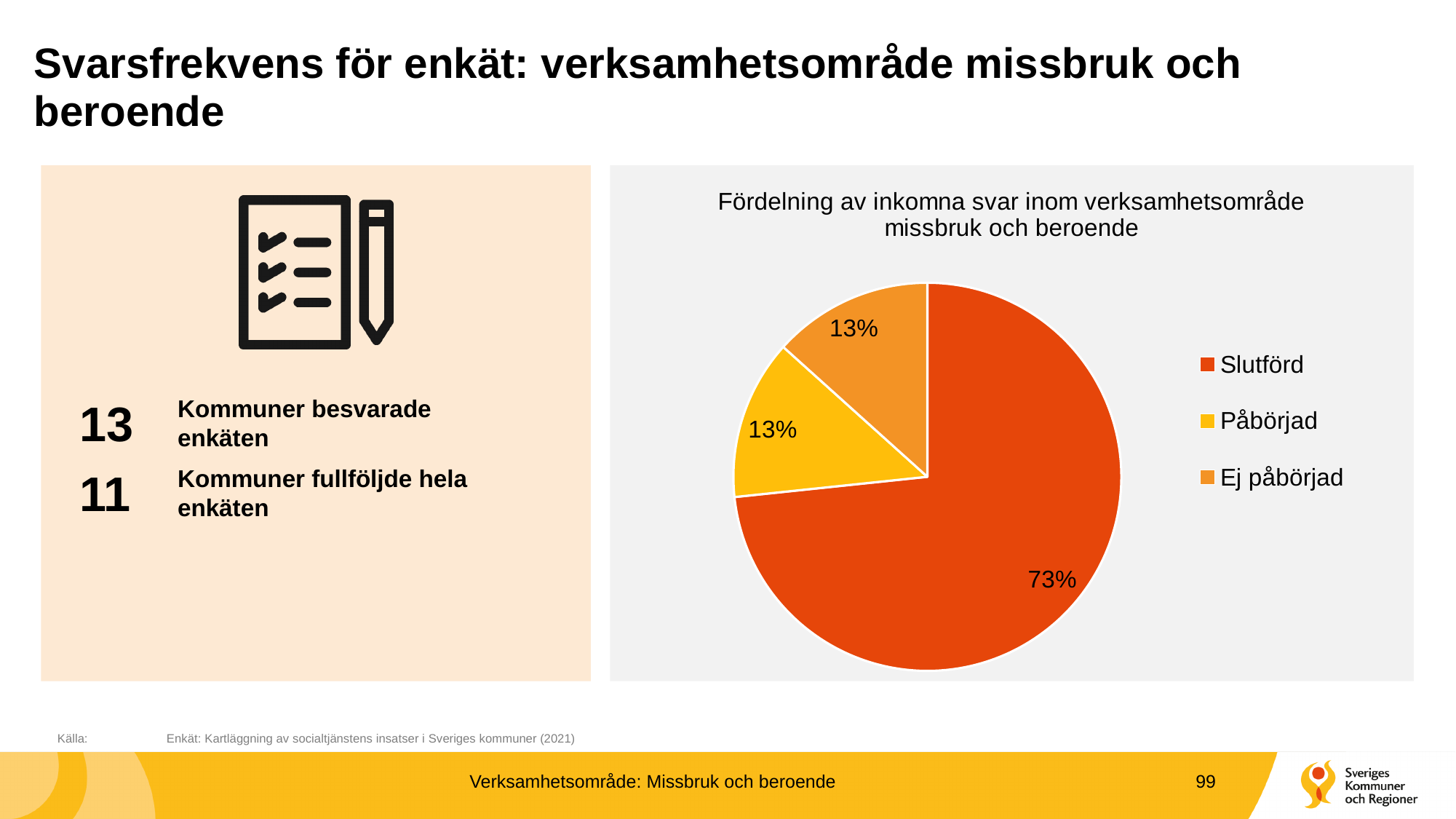
What is the difference between the Slutförd share and the Ej påbörjad share in the pie chart? 60 percentage points What is the title of the pie chart? Fördelning av inkomna svar inom verksamhetsområde missbruk och beroende What share of the pie chart is labelled Ej påbörjad? 13% How many entries does the legend of the pie chart list? 3 What share of the pie chart is labelled Slutförd? 73% Is the Slutförd share of the pie chart greater or less than 50%? greater Which legend entry in the pie chart is shown in yellow? Påbörjad Which category has the largest slice in the pie chart? Slutförd What share of the pie chart is labelled Påbörjad? 13% Which is larger in the pie chart, Slutförd or Påbörjad? Slutförd What kind of chart is shown on the slide? Pie chart How many slices does the pie chart have? 3